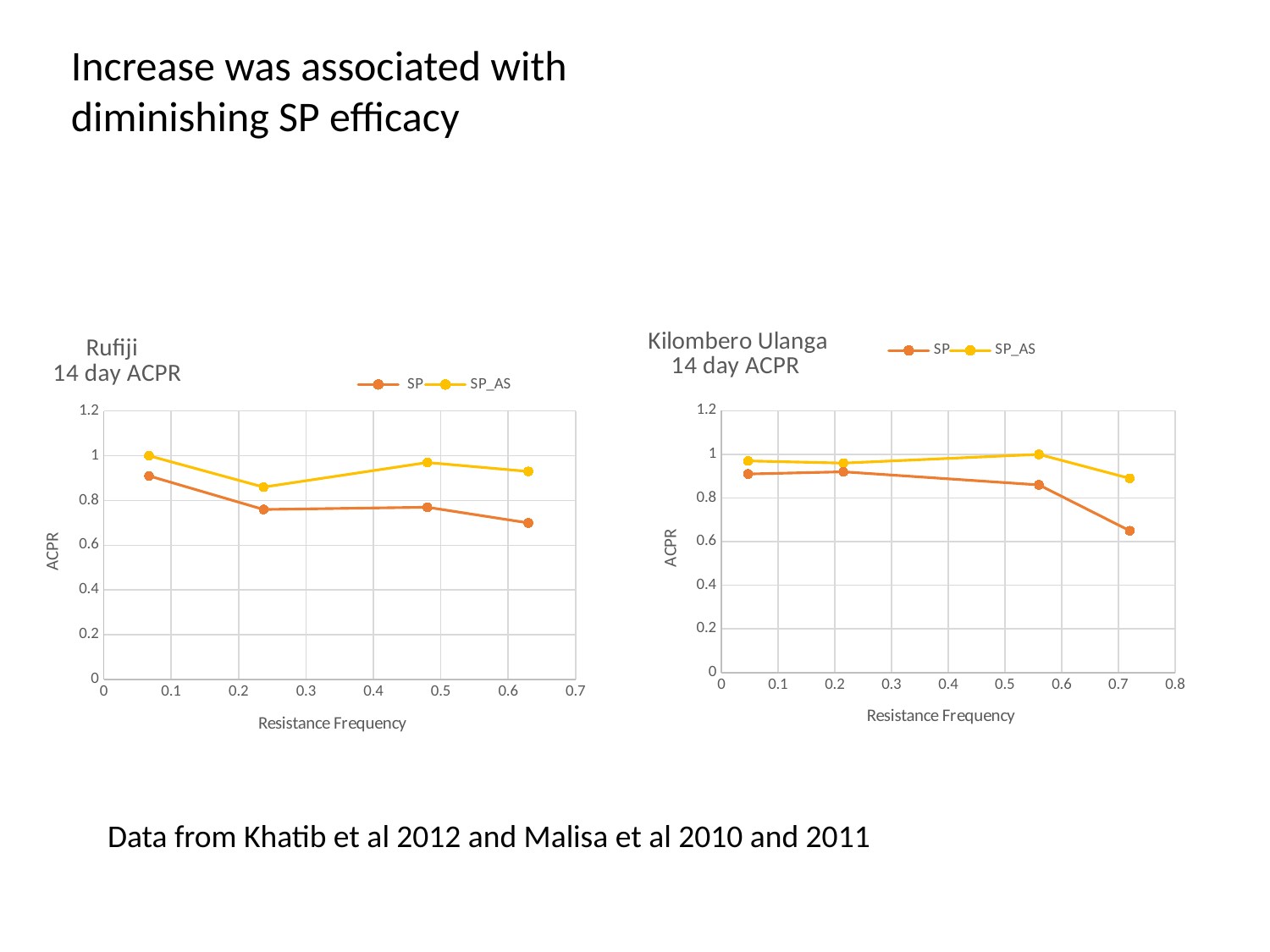
In the Kilombero Ulanga 14 day ACPR chart, how many data points are plotted for the SP_AS series? 4 In the Kilombero Ulanga 14 day ACPR chart, is the SP value at the highest resistance frequency greater or less than 0.8? less What kind of chart is the Rufiji 14 day ACPR chart? line chart How many series does the legend of the Kilombero Ulanga 14 day ACPR chart list? 2 In the Rufiji 14 day ACPR chart, how many data points are plotted for the SP series? 4 In the Rufiji 14 day ACPR chart, which series has the higher value at the highest resistance frequency, SP or SP_AS? SP_AS What is the x-axis title of the Rufiji 14 day ACPR chart? Resistance Frequency In the Kilombero Ulanga 14 day ACPR chart, which series has the higher value at the highest resistance frequency, SP or SP_AS? SP_AS In the Rufiji 14 day ACPR chart, is the SP value at the highest resistance frequency greater or less than 0.8? less In the Kilombero Ulanga 14 day ACPR chart, does the SP series overall rise or fall as resistance frequency increases? fall In the Kilombero Ulanga 14 day ACPR chart, is the SP_AS value at the highest resistance frequency greater or less than 0.8? greater What are the two legend entries in the Kilombero Ulanga 14 day ACPR chart? SP and SP_AS